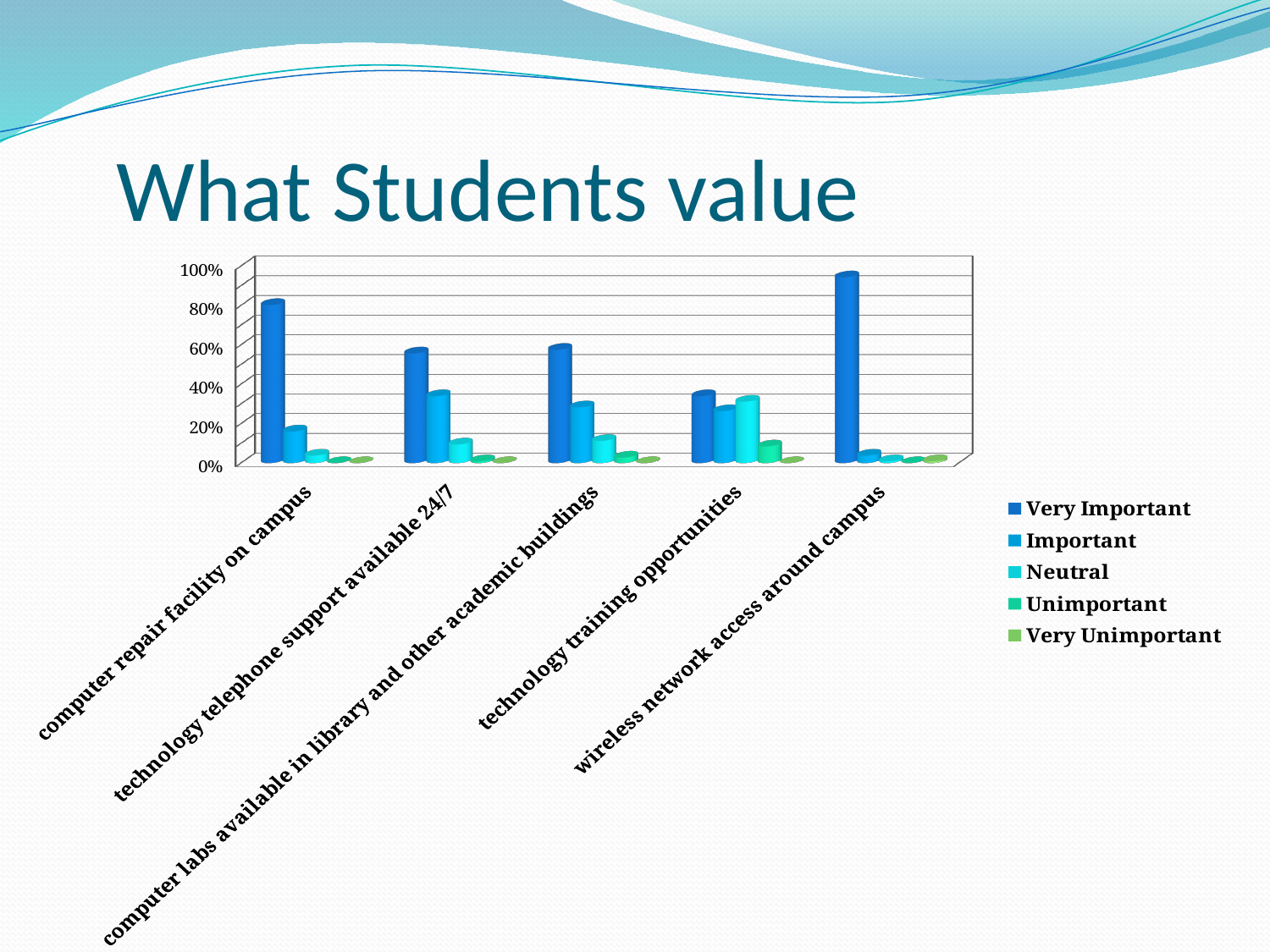
What kind of chart is shown on the slide? Bar chart How many series does the legend list? 5 What is the title of the slide containing the chart? What Students value How many categories are shown on the x axis of the chart? 5 Which category has the lowest Very Important value? technology training opportunities Is the Very Important value for technology training opportunities greater or less than 60%? less Which has the larger Very Important value: computer repair facility on campus or technology training opportunities? computer repair facility on campus Is the Important value for computer labs available in library and other academic buildings greater or less than 40%? less Which category has the highest Very Important value? wireless network access around campus Is the Very Important value for computer repair facility on campus greater or less than 60%? greater For computer repair facility on campus, which is larger: the Important value or the Neutral value? Important